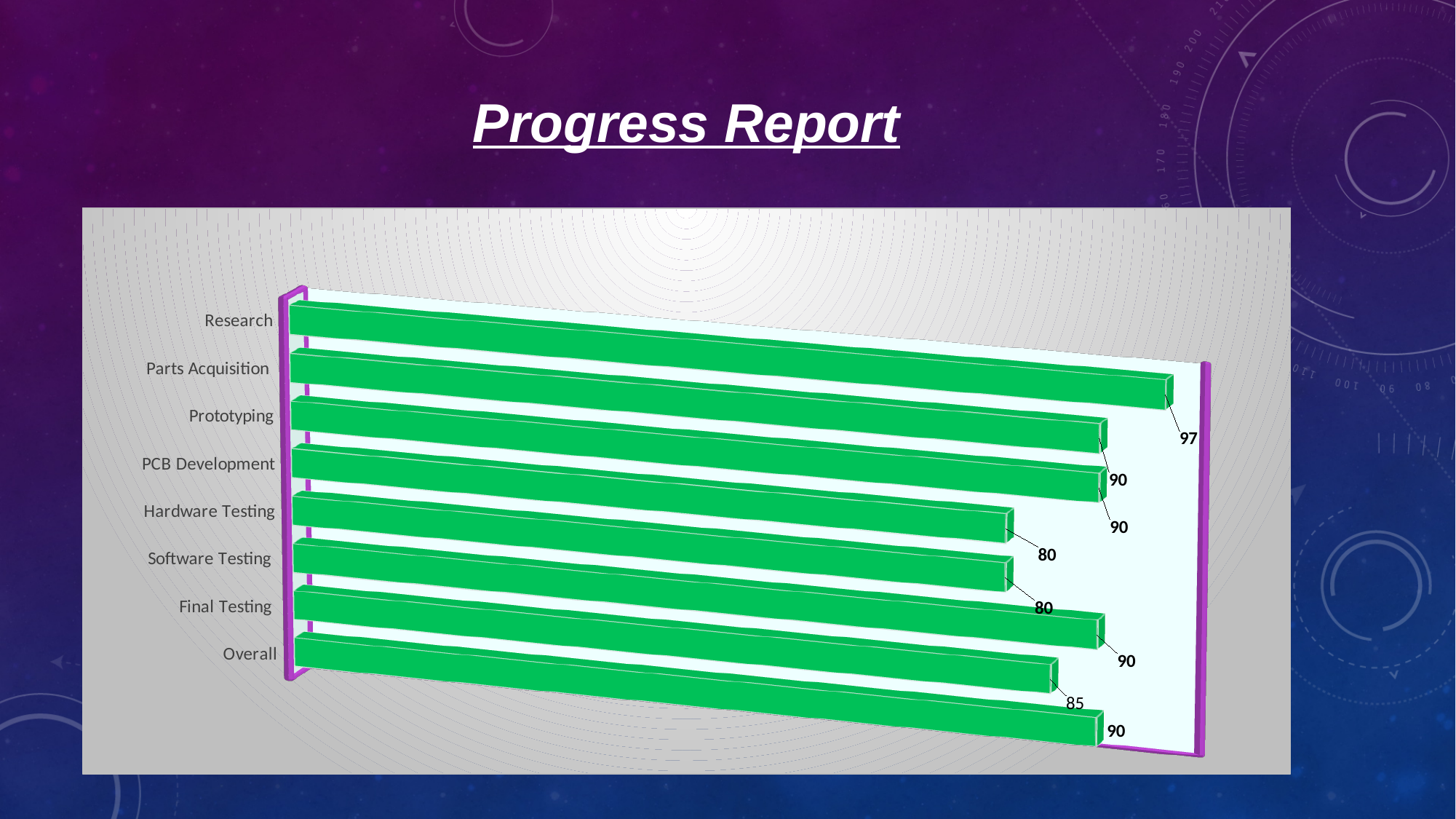
How many categories have a value of 90? 4 What is the value for Overall? 90 What is the value for Hardware Testing? 80 What is the difference between the values for Software Testing and PCB Development? 10 What kind of chart is shown on the slide? Bar chart Which category has the highest value? Research Which is larger, the value for Final Testing or the value for Hardware Testing? Final Testing What is the value for Research? 97 Which is larger, the value for Research or the value for Overall? Research What is the difference between the values for Research and Final Testing? 12 How many categories are shown in the chart? 8 What is the value for Final Testing? 85